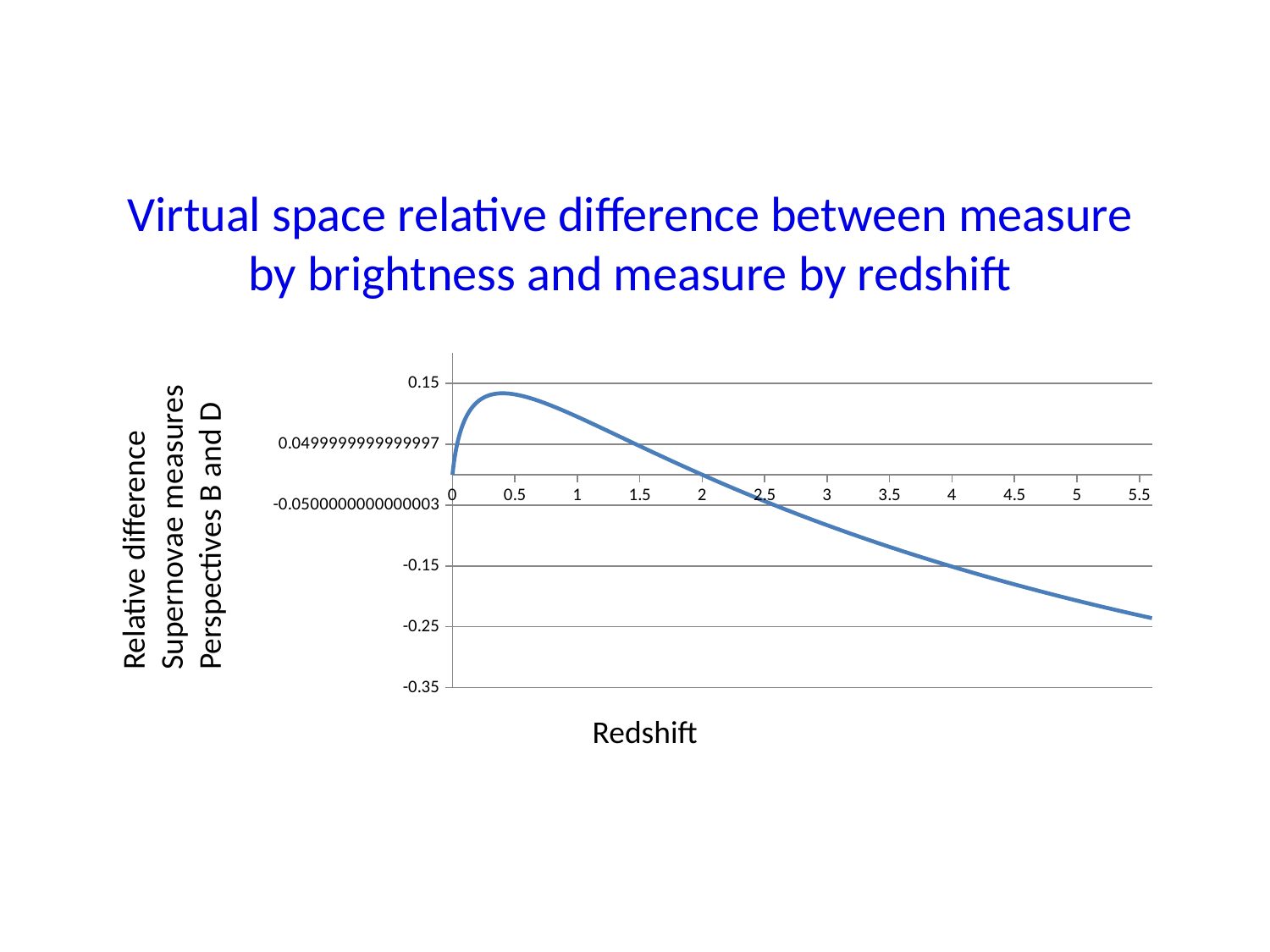
Is the value at redshift 5 greater or less than -0.15? less Does the line rise or fall between redshift 1 and redshift 5? fall What is the label of the x axis of the chart? Redshift Which is larger, the value at redshift 1 or the value at redshift 4? redshift 1 Is the value at redshift 1 greater or less than 0.05? greater What is the title of the chart on the slide? Virtual space relative difference between measure by brightness and measure by redshift Is the value at redshift 5.5 greater or less than -0.15? less How many tick labels are shown on the x axis? 12 What kind of chart is shown on the slide? line chart